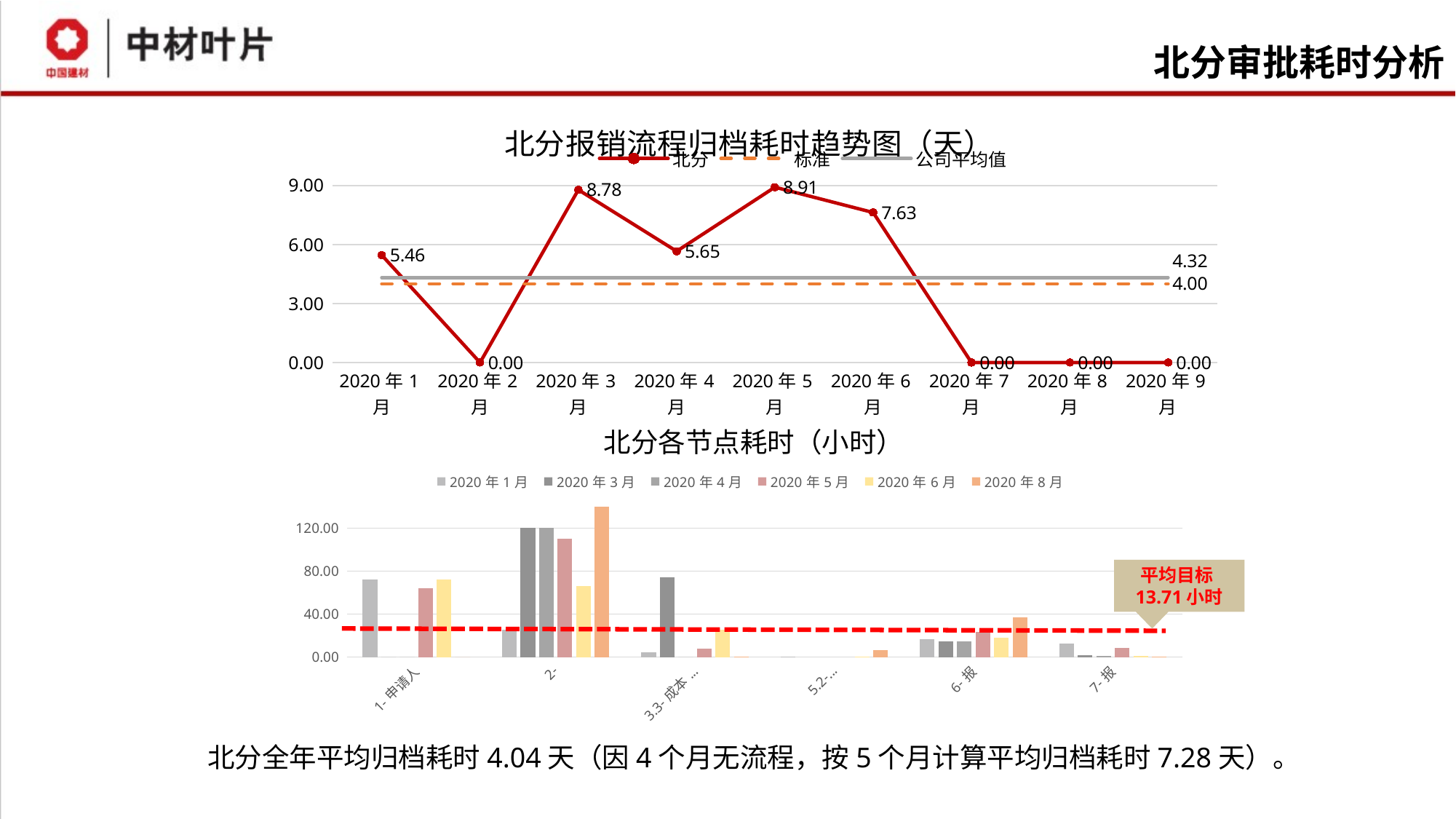
In the top chart 北分报销流程归档耗时趋势图（天）, what is the 北分 value for 2020年3月? 8.78 How many series does the legend of the bottom chart 北分各节点耗时（小时）list? 6 In the bottom chart 北分各节点耗时（小时）, is the 2020年1月 value for 1-申请人 greater or less than 40? greater In the top chart 北分报销流程归档耗时趋势图（天）, what is the difference between the 北分 values for 2020年6月 and 2020年4月? 1.98 How many months are plotted on the x axis of the top chart 北分报销流程归档耗时趋势图（天）? 9 What kind of chart is the top chart titled 北分报销流程归档耗时趋势图（天）? line chart How many series does the legend of the top chart 北分报销流程归档耗时趋势图（天）list? 3 In the top chart 北分报销流程归档耗时趋势图（天）, which is larger, the 北分 value for 2020年1月 or for 2020年4月? 2020年4月 In the top chart 北分报销流程归档耗时趋势图（天）, what is the 北分 value for 2020年6月? 7.63 In the top chart 北分报销流程归档耗时趋势图（天）, what is the value of the 公司平均值 line? 4.32 In the top chart 北分报销流程归档耗时趋势图（天）, does the 北分 value rise or fall from 2020年6月 to 2020年7月? fall In the top chart 北分报销流程归档耗时趋势图（天）, which month has the highest 北分 value? 2020年5月